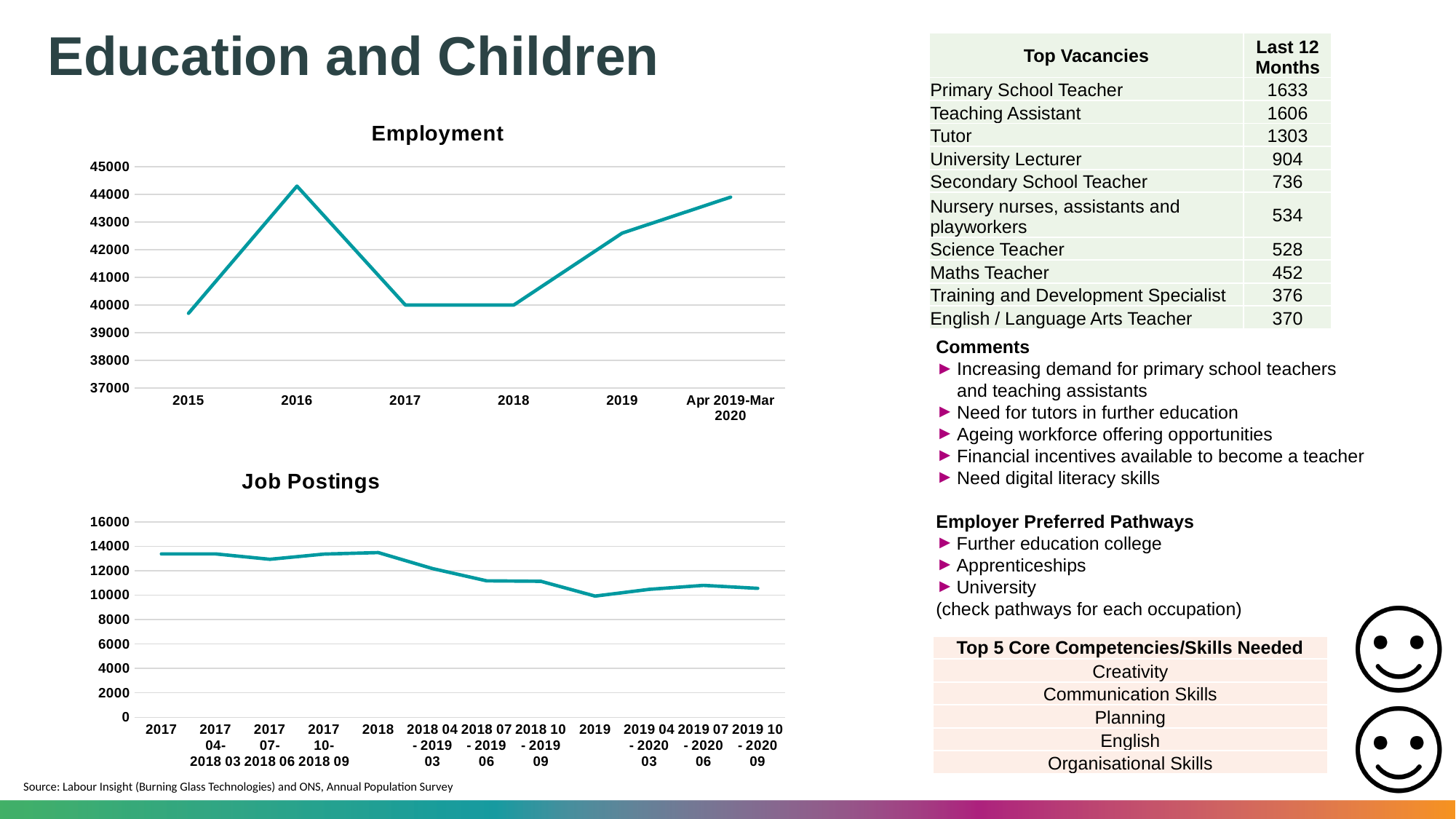
On the Employment chart, is the value for 2015 greater or less than 40000? less On the Employment chart, does employment rise or fall from 2018 to Apr 2019-Mar 2020? rise How many data points are plotted on the Employment chart? 6 On the Job Postings chart, which period has the lowest number of job postings? 2019 How many periods are plotted on the Job Postings chart? 12 What kind of chart is the Employment chart? line chart On the Employment chart, is the value for 2016 greater or less than 44000? greater On the Job Postings chart, which is larger, the value for 2017 or the value for 2019? 2017 What kind of chart is the Job Postings chart? line chart On the Job Postings chart, is the value for 2017 greater or less than 12000? greater On the Employment chart, which period has the highest employment? 2016